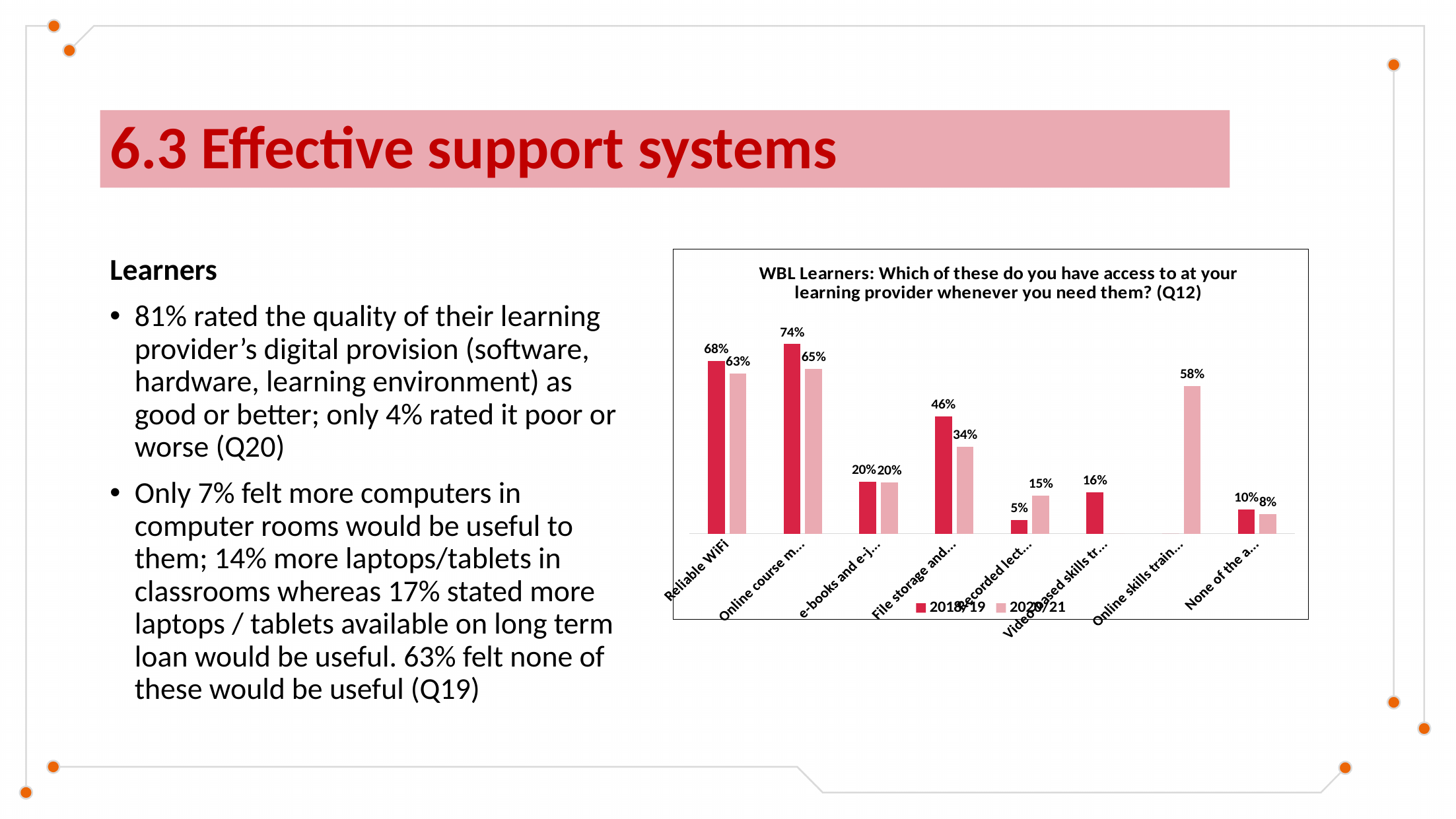
How many categories are shown on the x axis of the chart? 8 What is the 2020/21 value for the category labelled 'Online skills train...'? 58% How many series does the chart's legend list? 2 What is the difference between the 2018/19 and 2020/21 values for Reliable WiFi? 5% Which is larger for Reliable WiFi, the 2018/19 value or the 2020/21 value? 2018/19 What is the 2020/21 value for Reliable WiFi? 63% Which series is shown in the darker red colour in the chart? 2018/19 What kind of chart is shown on the slide? Bar chart What is the highest 2020/21 value shown in the chart? 65% What is the 2018/19 value for Reliable WiFi? 68% What is the highest 2018/19 value shown in the chart? 74% What is the 2018/19 value for the category labelled 'File storage and...'? 46%